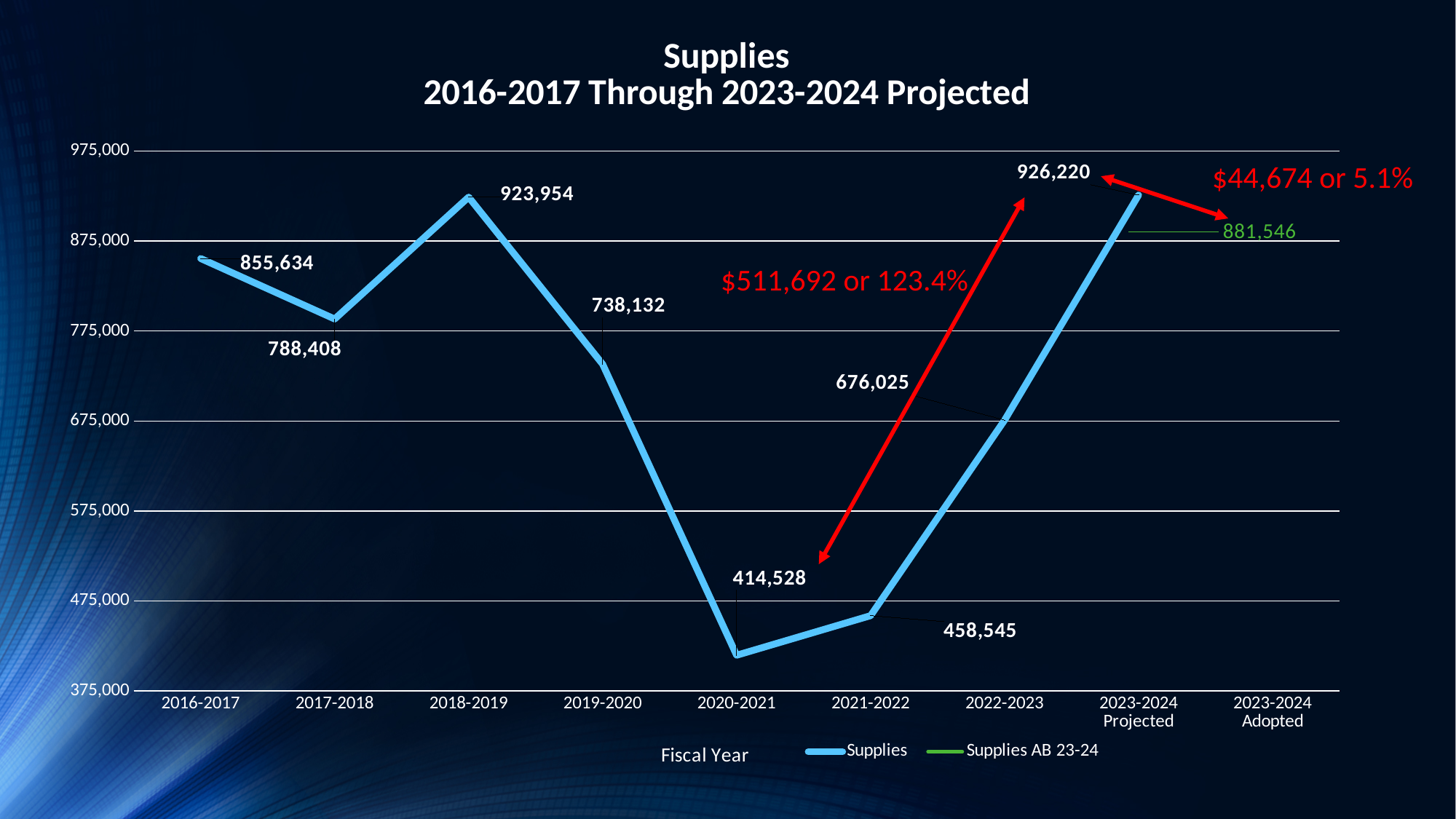
What is the Supplies value for 2020-2021? 414,528 What is the Supplies value for 2018-2019? 923,954 Which fiscal year has the highest Supplies value? 2023-2024 Projected Is the Supplies value for 2021-2022 greater or less than 475,000? less Do the Supplies values rise or fall from 2020-2021 to 2023-2024 Projected? rise What is the difference between the Supplies values for 2016-2017 and 2017-2018? 67,226 Which fiscal year has the lowest Supplies value? 2020-2021 What is the Supplies value for 2023-2024 Projected? 926,220 How many series does the legend list? 2 What is the value shown for Supplies AB 23-24 (2023-2024 Adopted)? 881,546 What kind of chart is shown on the slide? line chart Which is larger, the Supplies value for 2019-2020 or for 2022-2023? 2019-2020